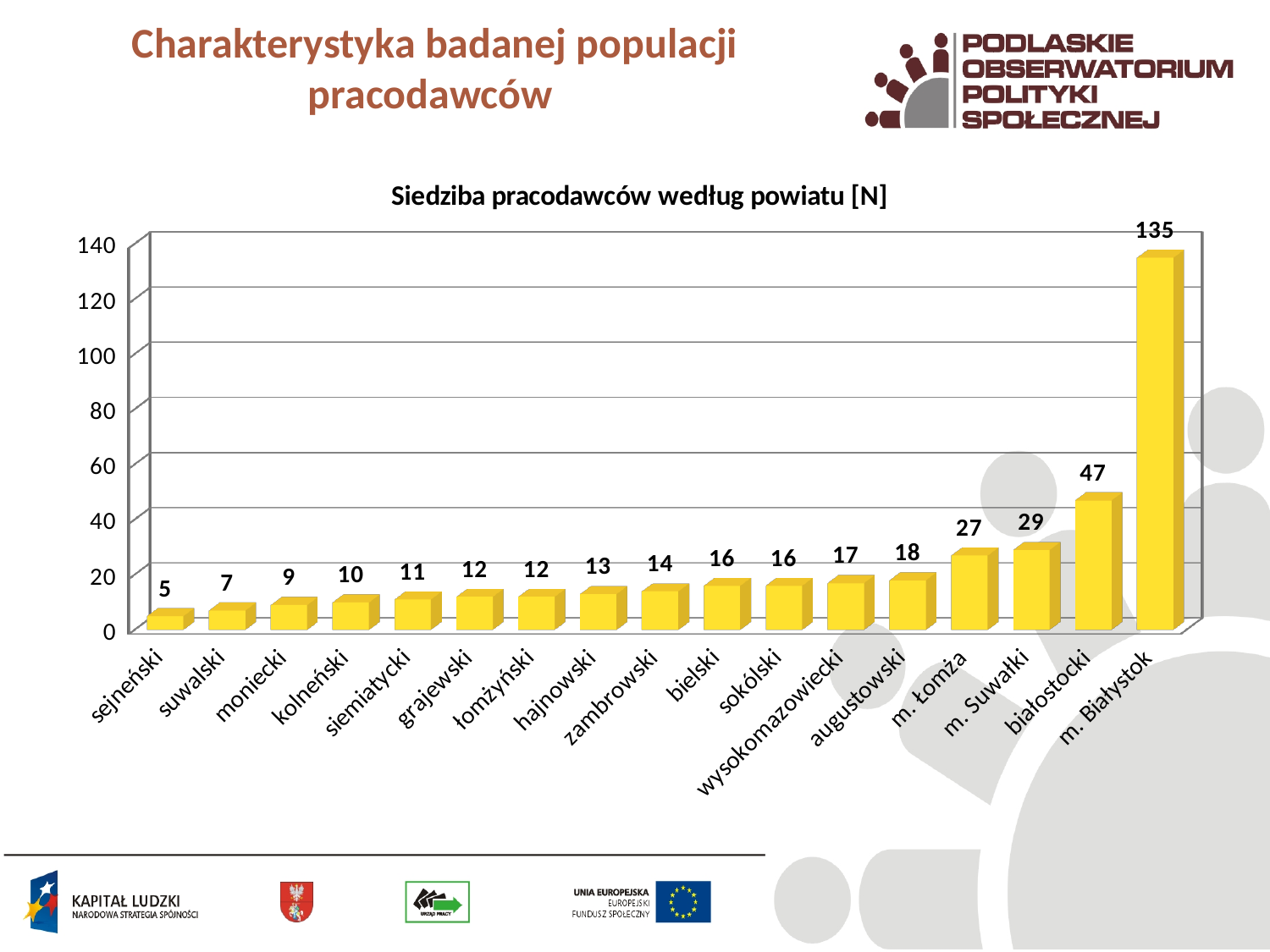
What is the value for sejneński? 5 What kind of chart is this? bar chart What is the title of the chart? Siedziba pracodawców według powiatu [N] Which is larger, the value for bielski or the value for moniecki? bielski Which powiat has the lowest value? sejneński How many powiats (categories) are shown on the x axis? 17 What is the value for m. Białystok? 135 What is the value for augustowski? 18 What is the value for białostocki? 47 Which powiat has the highest value? m. Białystok What is the difference between the values for m. Białystok and białostocki? 88 What is the difference between the values for m. Suwałki and m. Łomża? 2